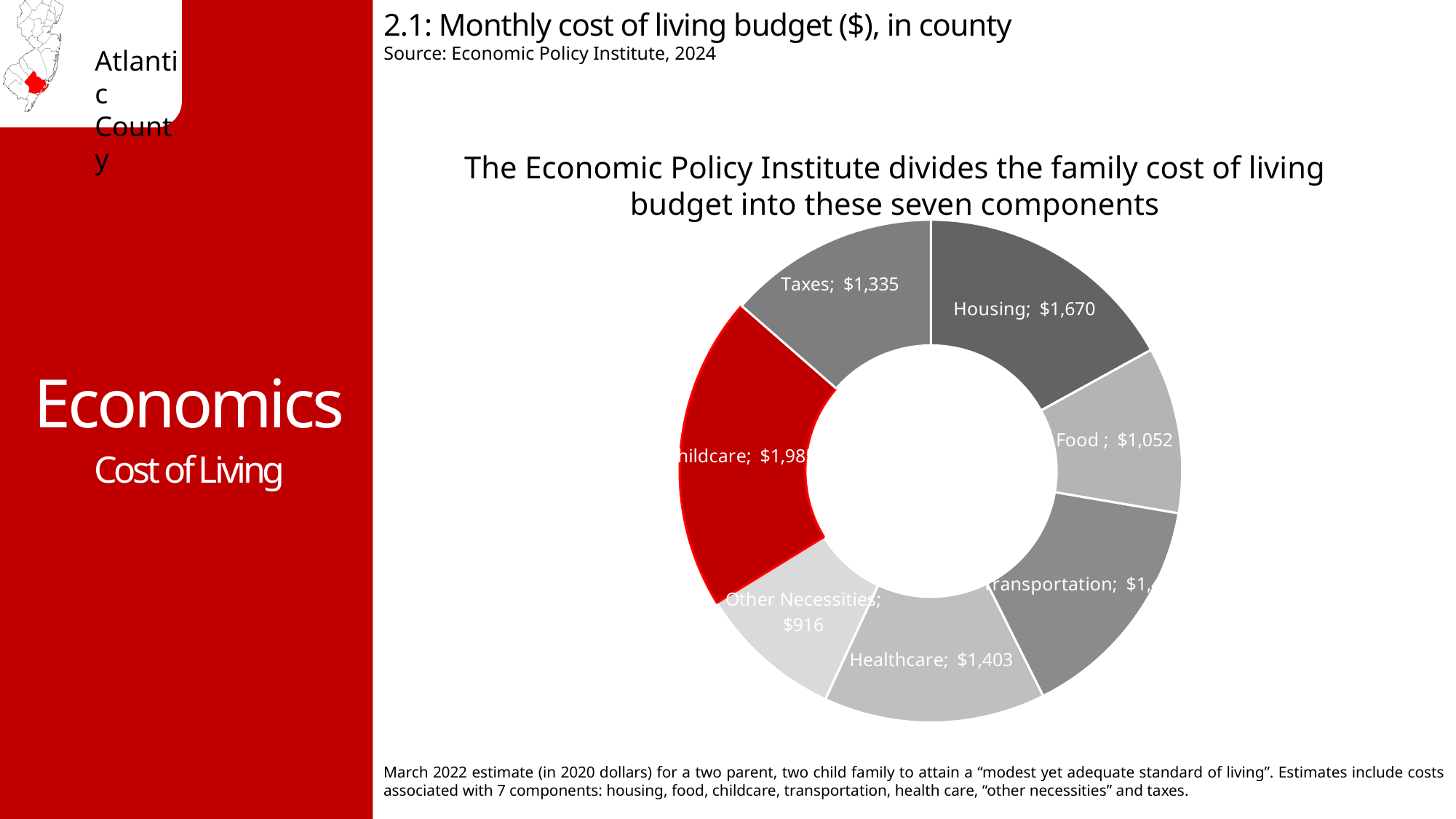
What is the monthly cost for Food shown on the chart? $1,052 What is the monthly cost for Other Necessities shown on the chart? $916 Which is larger, the monthly cost for Taxes or for Healthcare? Healthcare Which component has the smallest monthly cost in the chart? Other Necessities What is the monthly cost for Housing shown on the chart? $1,670 What is the monthly cost for Taxes shown on the chart? $1,335 What kind of chart is shown on the slide? Doughnut (pie) chart What is the monthly cost for Healthcare shown on the chart? $1,403 Which component has the largest monthly cost in the chart? Childcare How many components are shown in the chart? 7 Which component is highlighted in red on the chart? Childcare How much more is the monthly cost for Housing than for Food? $618